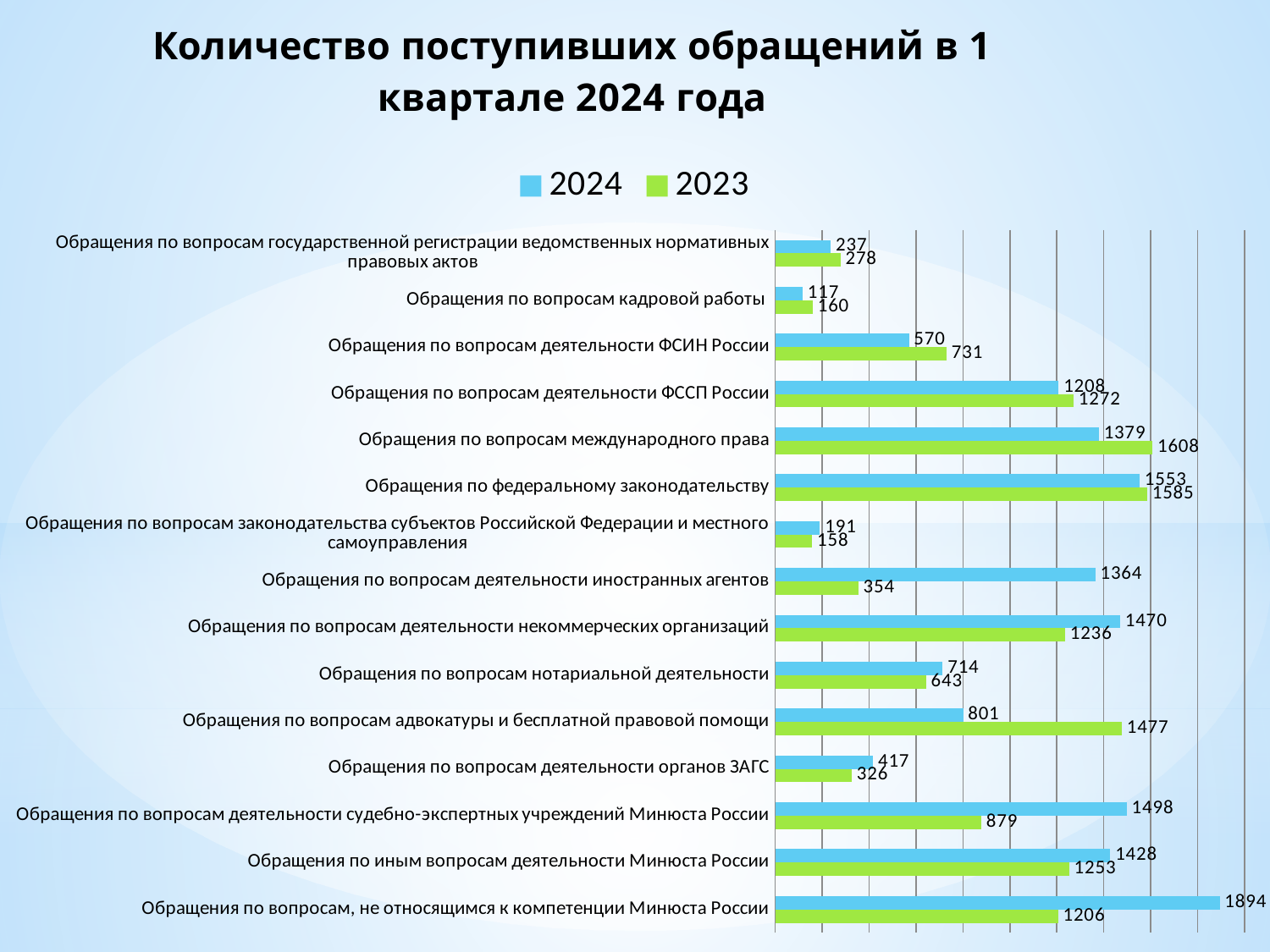
For «Обращения по вопросам деятельности органов ЗАГС», which year has the larger value, 2024 or 2023? 2024 Which category has the highest 2024 value? Обращения по вопросам, не относящимся к компетенции Минюста России How many series does the legend list? 2 Which category has the highest 2023 value? Обращения по вопросам международного права What is the 2023 value for «Обращения по вопросам адвокатуры и бесплатной правовой помощи»? 1477 How many categories are shown in the chart? 15 What type of chart is shown on the slide? bar chart What is the 2024 value for «Обращения по вопросам деятельности иностранных агентов»? 1364 What is the difference between the 2023 and 2024 values for «Обращения по вопросам деятельности ФСИН России»? 161 Which category has the lowest 2024 value? Обращения по вопросам кадровой работы What colour represents the 2023 series in the chart? green What is the difference between the 2024 and 2023 values for «Обращения по вопросам деятельности судебно-экспертных учреждений Минюста России»? 619